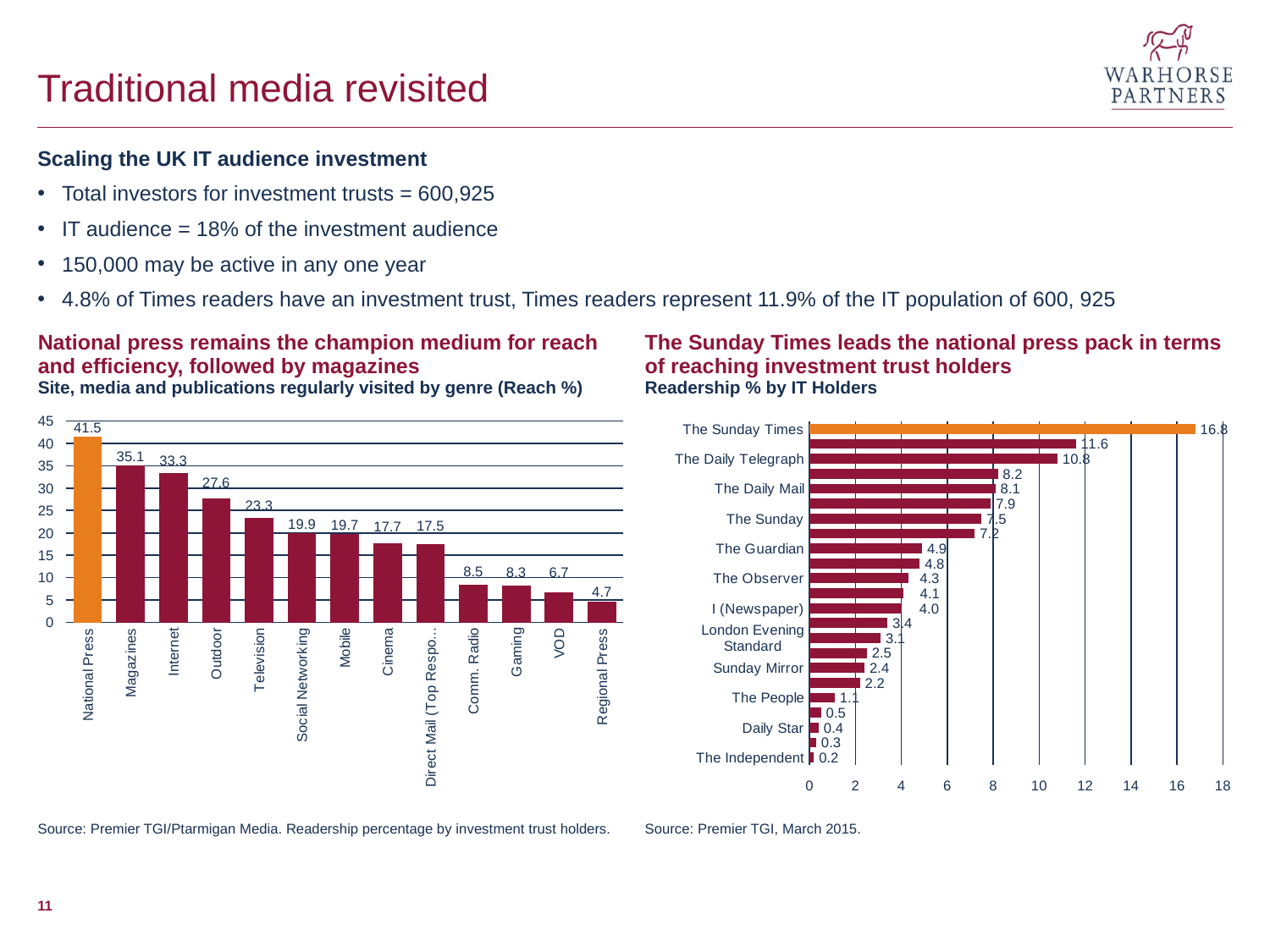
In the left chart (Reach %), which is larger, Comm. Radio or VOD? Comm. Radio In the right chart (Readership % by IT Holders), which publication has the highest value? The Sunday Times In the left chart (Reach %), which category has the lowest value? Regional Press In the 'Site, media and publications regularly visited by genre (Reach %)' chart on the left, what is the value for National Press? 41.5 In the right chart (Readership % by IT Holders), what is the difference between The Daily Telegraph and The Daily Mail? 2.7 In the 'Readership % by IT Holders' chart on the right, what is the value for The Sunday Times? 16.8 How many categories are shown in the left chart (Reach %)? 13 In the left chart (Reach %), which bar is coloured orange rather than red? National Press In the left chart (Reach %), what is the difference between Magazines and Internet? 1.8 What kind of chart is the 'Readership % by IT Holders' chart on the right? Bar chart In the right chart (Readership % by IT Holders), what is the value for The Guardian? 4.9 In the left chart (Reach %), what is the value for Television? 23.3